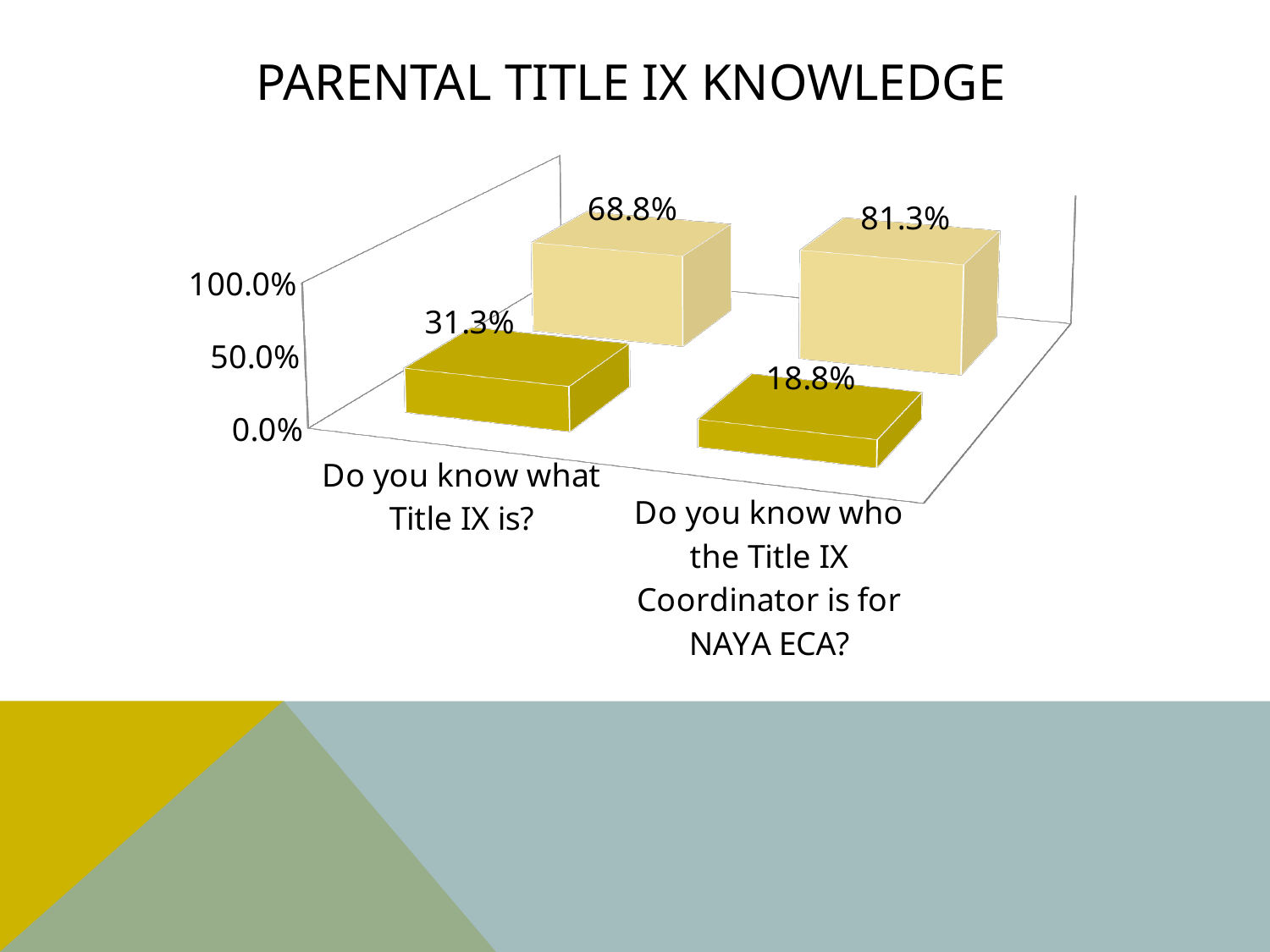
Which bar has the lowest value in the chart? The dark gold (front) bar for "Do you know who the Title IX Coordinator is for NAYA ECA?" at 18.8% What is the value of the dark gold (front) bar for "Do you know what Title IX is?"? 31.3% What is the title of the chart? PARENTAL TITLE IX KNOWLEDGE What is the value of the light (back) bar for "Do you know what Title IX is?"? 68.8% How many bars are plotted in the chart in total? 4 What type of chart is shown on the slide? bar chart Which bar has the highest value in the chart? The light (back) bar for "Do you know who the Title IX Coordinator is for NAYA ECA?" at 81.3% What is the value of the light (back) bar for "Do you know who the Title IX Coordinator is for NAYA ECA?"? 81.3% What is the value of the dark gold (front) bar for "Do you know who the Title IX Coordinator is for NAYA ECA?"? 18.8% How many question categories are shown on the x axis of the chart? 2 Which is larger: the light (back) bar for "Do you know what Title IX is?" or the light (back) bar for "Do you know who the Title IX Coordinator is for NAYA ECA?"? Do you know who the Title IX Coordinator is for NAYA ECA? What is the difference between the two dark gold (front) bars, 31.3% and 18.8%? 12.5%